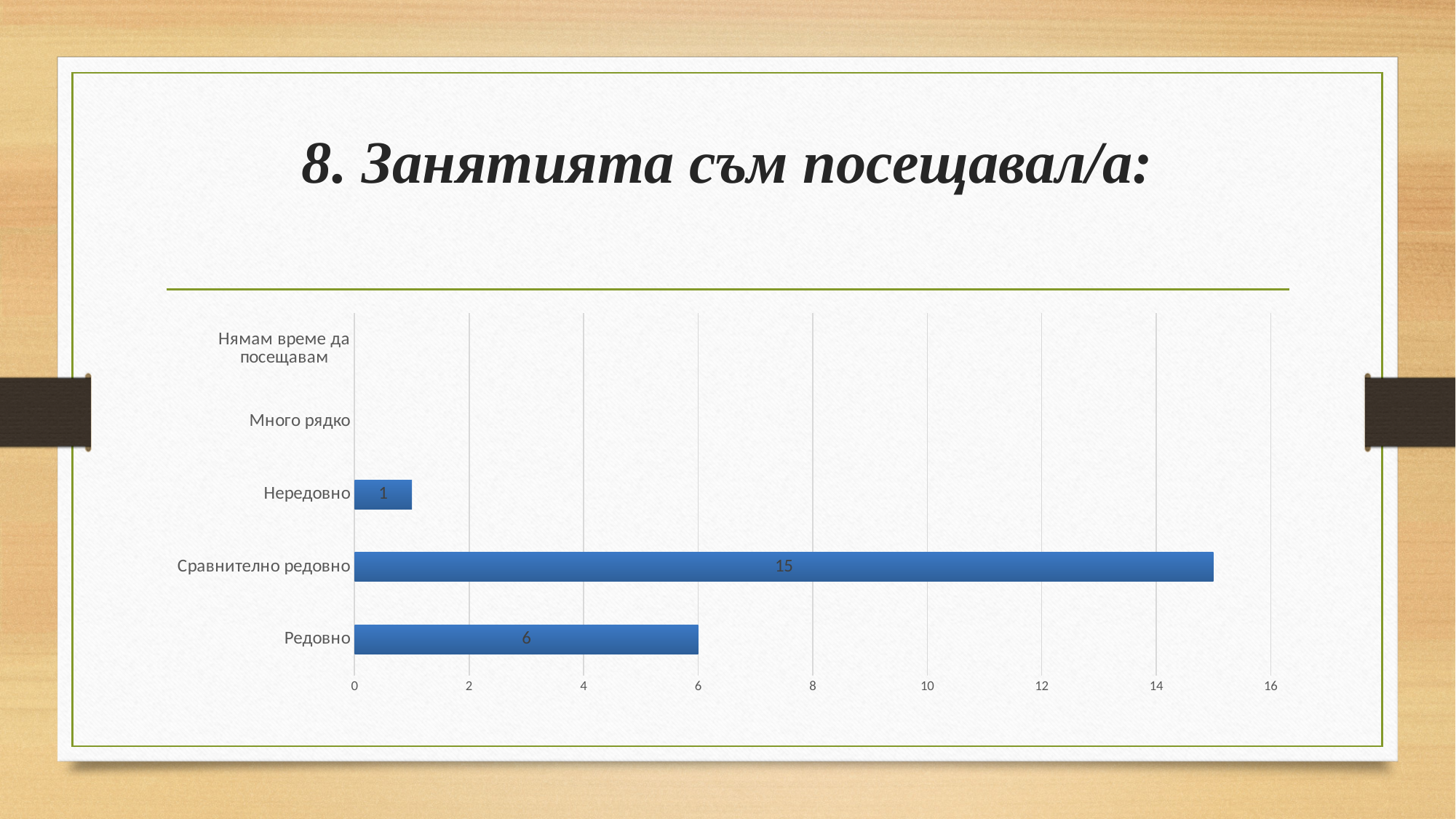
What is the value for Сравнително редовно? 15 Which category has the highest value? Сравнително редовно What is the title of the slide? 8. Занятията съм посещавал/а: What is the difference between the values for Сравнително редовно and Редовно? 9 How many categories are listed on the vertical axis? 5 Which category with a visible bar has the lowest value? Нередовно What is the value for Нередовно? 1 What is the difference between the values for Редовно and Нередовно? 5 What kind of chart is shown on the slide? bar chart Is the value for Сравнително редовно greater or less than 14? greater What is the value for Редовно? 6 Which is larger, the value for Редовно or the value for Нередовно? Редовно